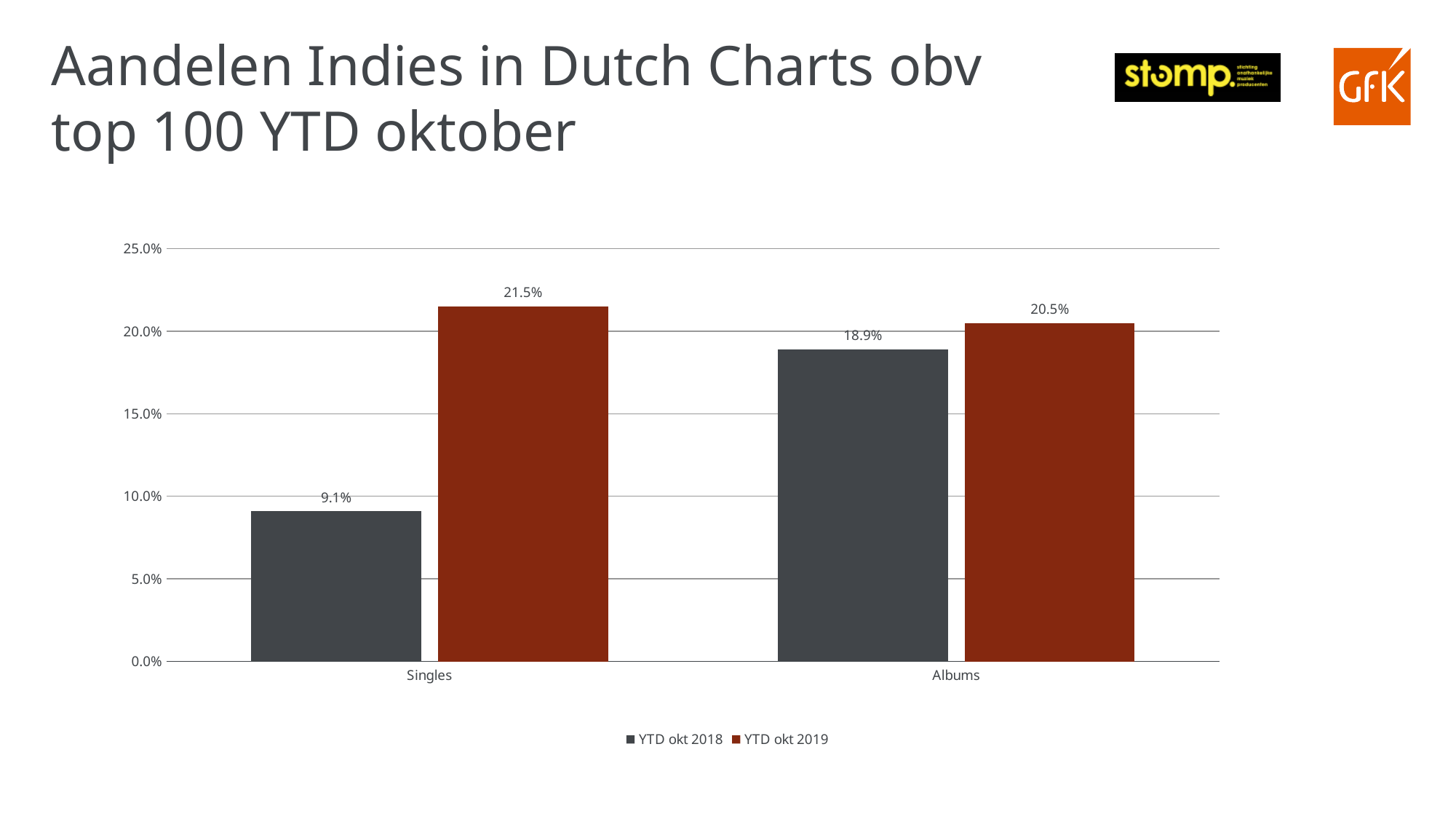
What kind of chart is shown on the slide? Bar chart What is the difference between the YTD okt 2019 and YTD okt 2018 values for Singles? 12.4% What is the value for Singles in the YTD okt 2018 series? 9.1% Which is larger: the YTD okt 2018 value for Albums or the YTD okt 2019 value for Singles? YTD okt 2019 value for Singles What is the value for Albums in the YTD okt 2019 series? 20.5% Which category has the highest value in the YTD okt 2019 series? Singles How many series does the legend list? 2 Which category has the lowest value in the YTD okt 2018 series? Singles What is the value for Albums in the YTD okt 2018 series? 18.9% How many categories are shown on the x axis? 2 What is the difference between the YTD okt 2019 and YTD okt 2018 values for Albums? 1.6% What is the value for Singles in the YTD okt 2019 series? 21.5%